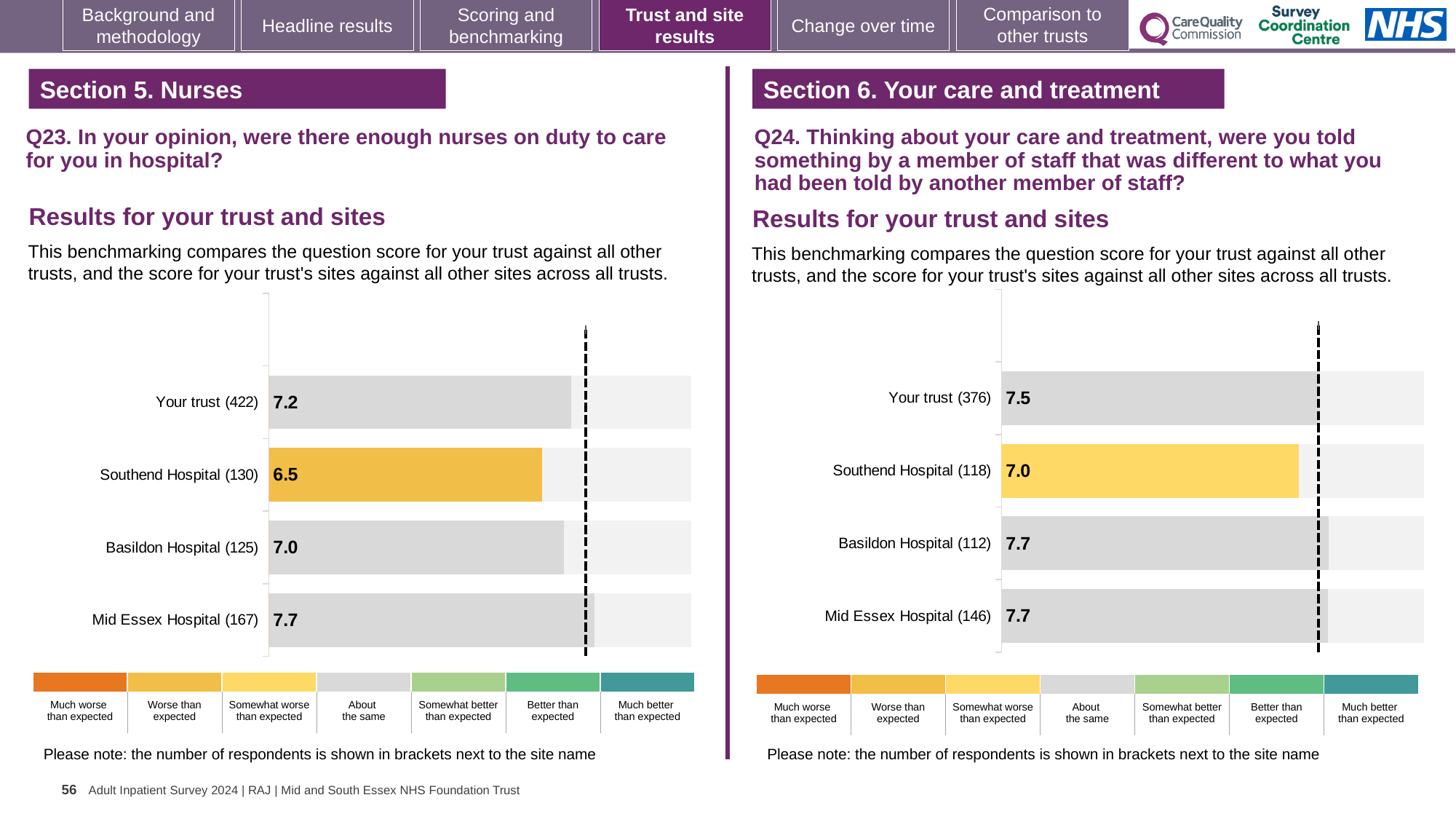
In the Q24 chart on the right, which site has the lowest score? Southend Hospital In the Q24 chart on the right, what is the score for Basildon Hospital? 7.7 In the Q23 chart on the left, what is the difference between the scores for Mid Essex Hospital and Southend Hospital? 1.2 In the Q24 chart on the right, which is larger, the score for Your trust or the score for Southend Hospital? Your trust In the Q23 chart on the left, which site has the lowest score? Southend Hospital In the Q23 chart on the left, which site has the highest score? Mid Essex Hospital In the Q23 chart on the left, what is the score for Your trust? 7.2 In the Q23 chart on the left, how many bars are plotted? 4 In the Q23 chart on the left, what is the score for Southend Hospital? 6.5 In the Q24 chart on the right, what is the score for Your trust? 7.5 In the Q24 chart on the right, what is the difference between the scores for Mid Essex Hospital and Your trust? 0.2 What type of chart is used for the Q23 results on the left? Bar chart